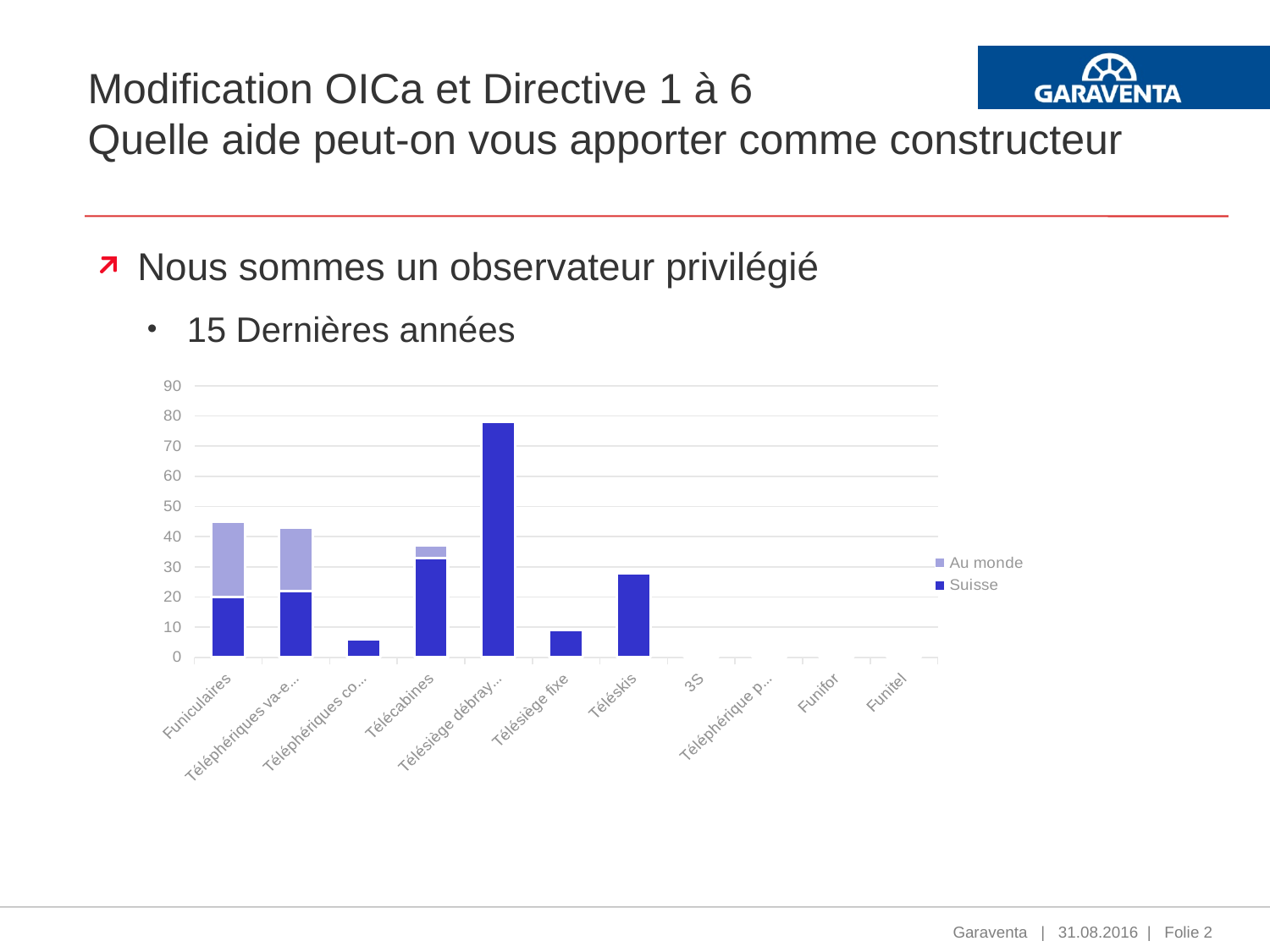
Is the value for Télésiège débray... greater or less than 70? greater Which category has the tallest bar in the chart? Télésiège débray... Which has the taller bar, Télécabines or Téléskis? Télécabines Is the Suisse value for Téléskis greater or less than 30? less Is the total stacked value for Funiculaires greater or less than 40? greater How many series does the chart legend list? 2 Which two series are listed in the chart legend? Au monde and Suisse How many categories are shown on the x axis of the chart? 11 Which colour represents the Suisse series in the chart? Dark blue What kind of chart is shown on the slide? Stacked bar chart